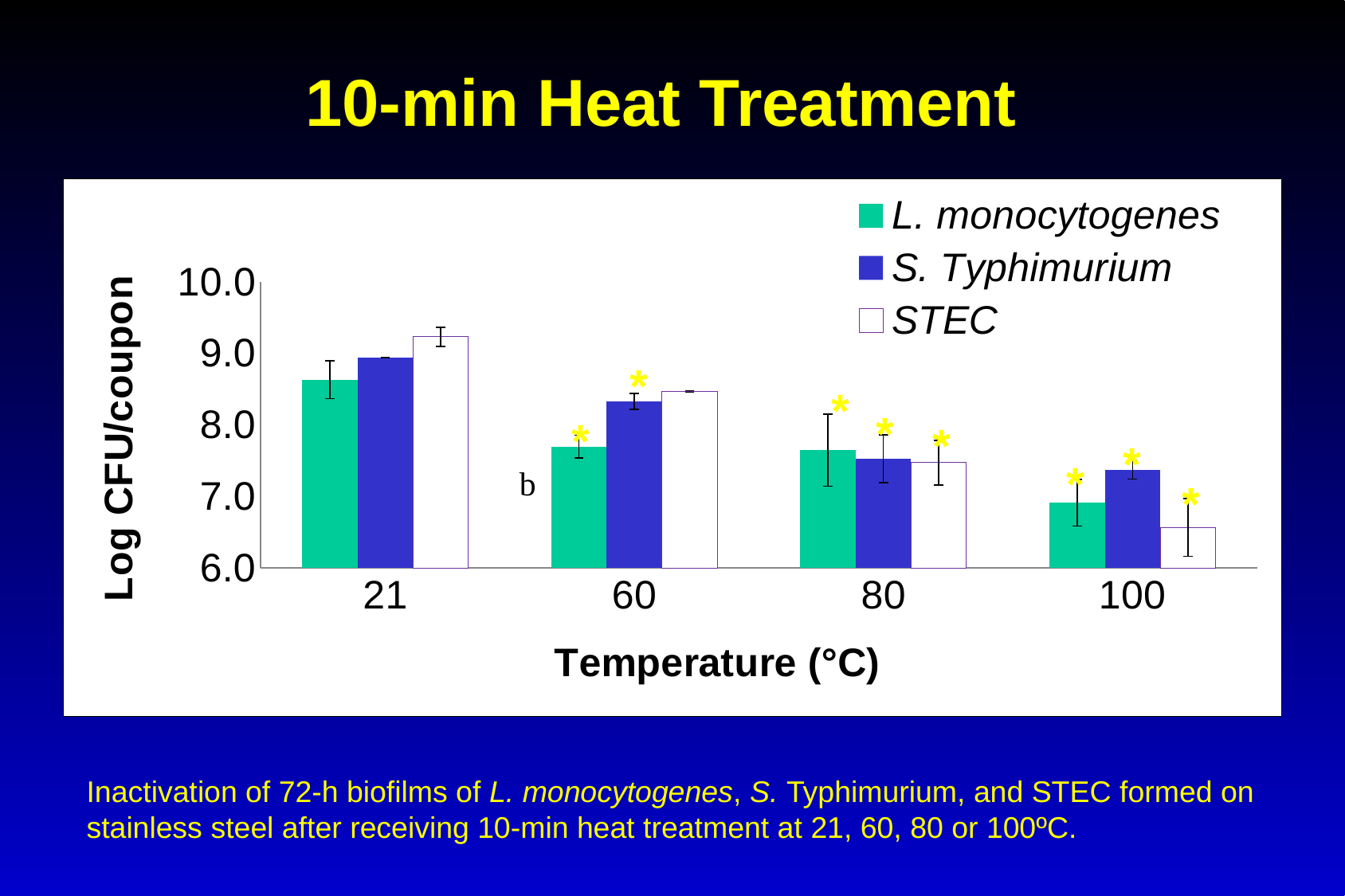
Which series has the highest value at 21°C? STEC Is the value for L. monocytogenes at 21°C greater or less than 9.0? less What kind of chart is shown on the slide? bar chart Is the value for STEC at 21°C greater or less than 9.0? greater What is the title of the y axis? Log CFU/coupon Is the value for STEC at 100°C greater or less than 7.0? less Which series has the lowest value at 100°C? STEC Do the L. monocytogenes values rise or fall as temperature increases from 21 to 100°C? fall How many temperature categories are shown on the x axis? 4 Which is larger: the STEC value at 21°C or the STEC value at 100°C? 21°C How many series does the legend list? 3